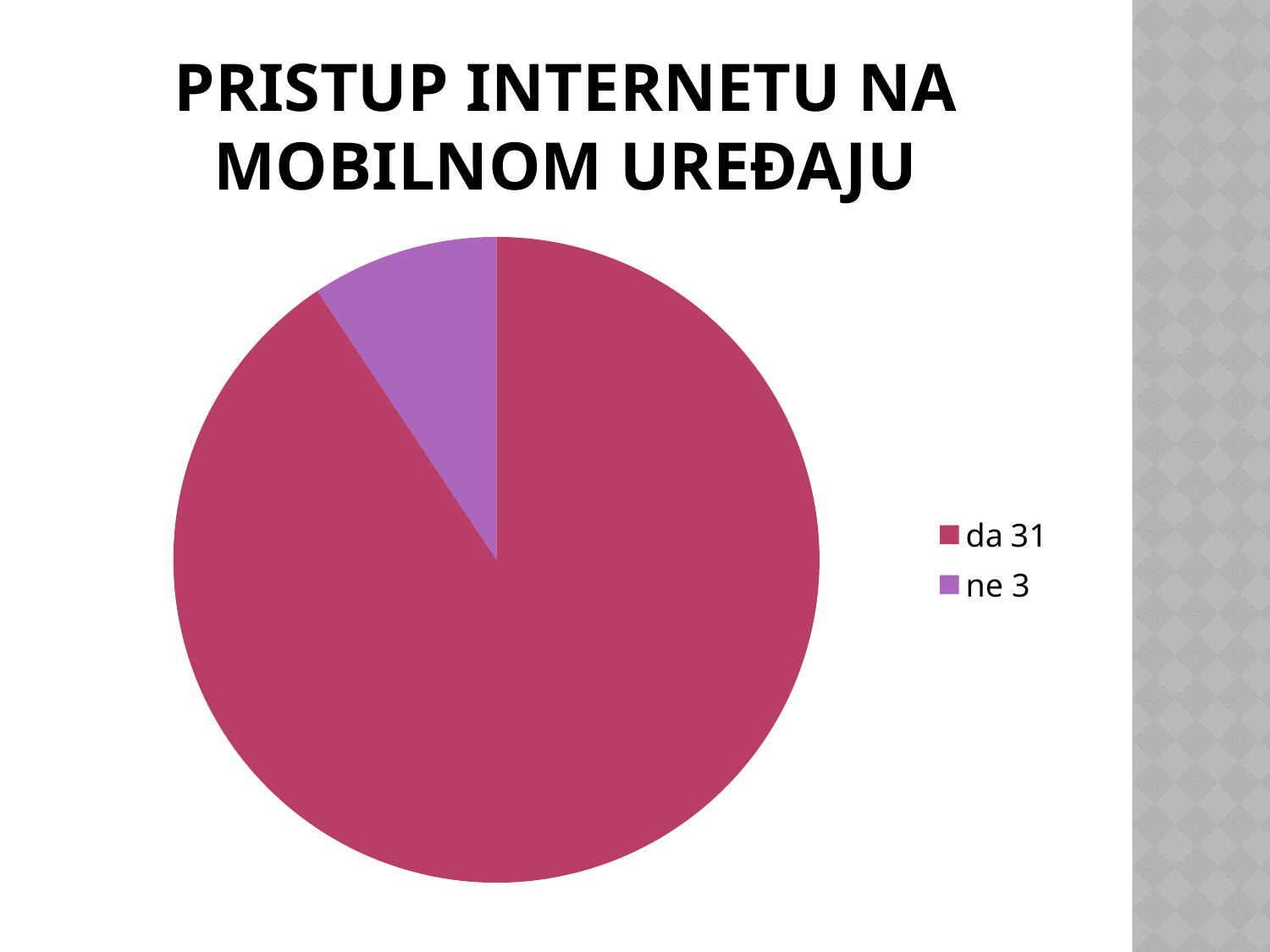
What is the value for "ne" in the pie chart? 3 What is the total of all the values in the pie chart? 34 What is the difference between the values for "da" and "ne"? 28 What kind of chart is shown on the slide? pie chart How many categories does the pie chart have? 2 What is the value for "da" in the pie chart? 31 Which is larger, the value for "da" or the value for "ne"? da Which category has the largest slice of the pie? da What colour is the slice for "ne" in the pie chart? purple Which category has the smallest slice of the pie? ne What is the title of the chart on the slide? PRISTUP INTERNETU NA MOBILNOM UREĐAJU